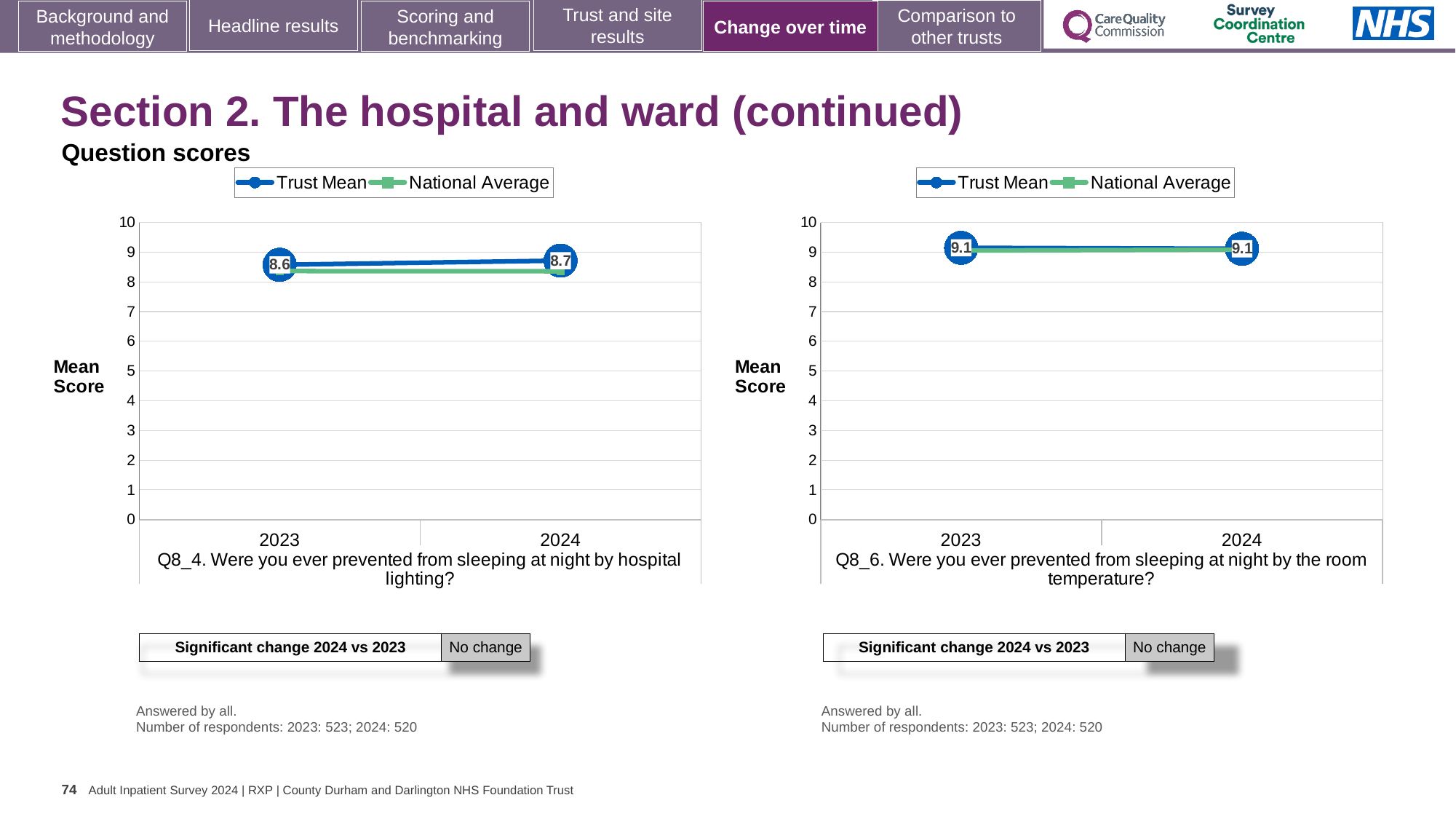
In the Q8_4 chart (left), what is the difference between the Trust Mean for 2024 and for 2023? 0.1 In the Q8_6 chart (right), is the National Average for 2024 greater or less than 8? greater In the Q8_4 chart (left), is the National Average for 2023 greater or less than 9? less How many years are shown on the x axis of the Q8_6 chart (right)? 2 In the Q8_4 chart (left), does the Trust Mean rise or fall from 2023 to 2024? rise What kind of chart is the Q8_6 chart (right)? line chart In the Q8_6 chart (right), what is the Trust Mean for 2024? 9.1 In the Q8_4 chart (left), what is the Trust Mean for 2024? 8.7 In the Q8_4 chart (left), what is the Trust Mean for 2023? 8.6 In the Q8_4 chart (left), which year has the higher Trust Mean, 2023 or 2024? 2024 How many series does the legend of the Q8_4 chart (left) list? 2 In the Q8_6 chart (right), does the Trust Mean rise, fall or stay the same from 2023 to 2024? stays the same